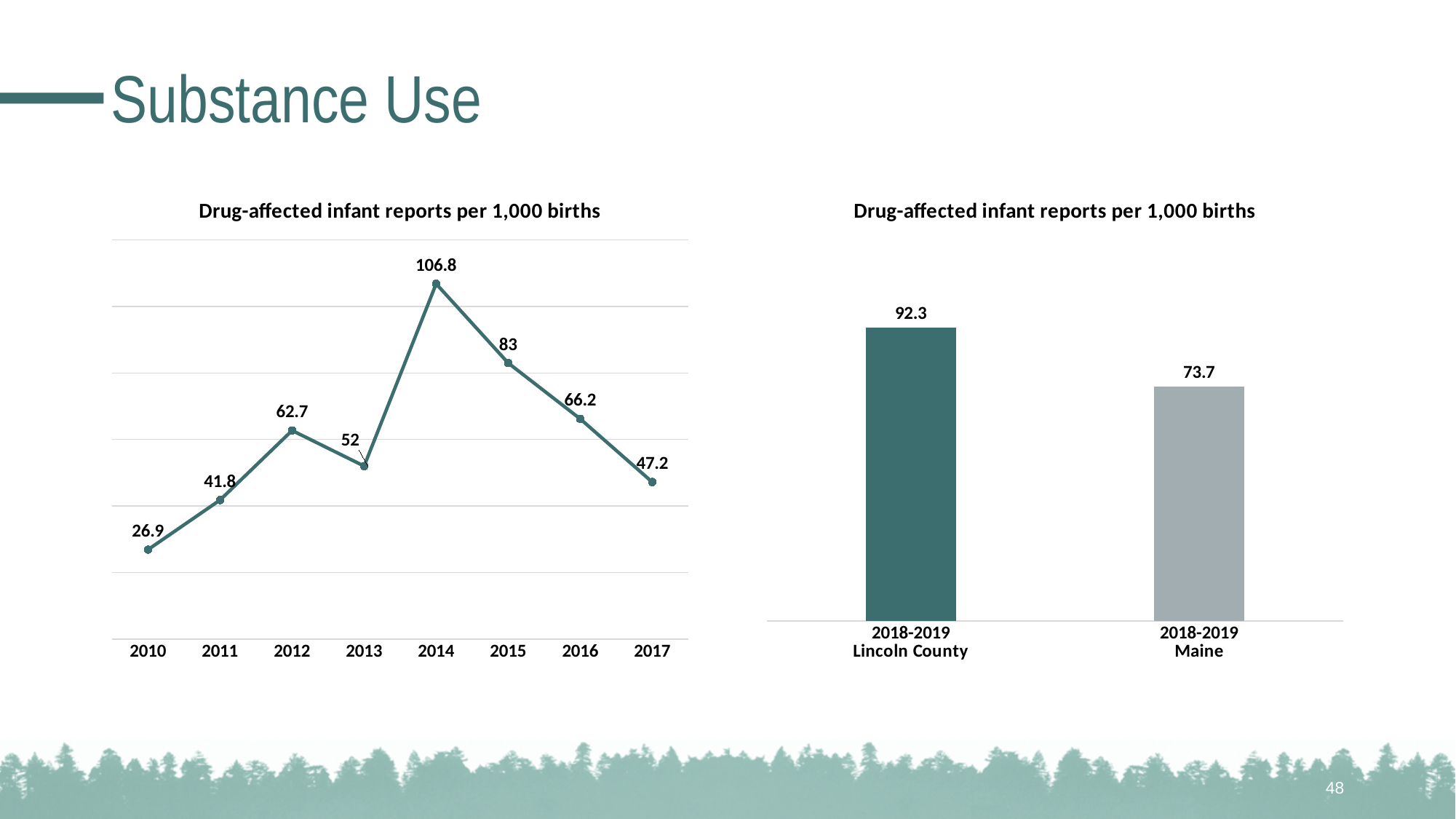
In the left line chart, what is the value for 2010? 26.9 In the left line chart, which is larger, the value for 2012 or the value for 2013? 2012 In the left line chart, how many years are plotted? 8 In the right bar chart, what is the value for 2018-2019 Maine? 73.7 In the left line chart, which year has the lowest value? 2010 In the left line chart, what is the difference between the values for 2014 and 2015? 23.8 In the left line chart, what is the value for 2014? 106.8 In the left line chart, which year has the highest value? 2014 In the left line chart, do the values rise or fall from 2014 to 2017? fall What kind of chart is the chart on the right? bar chart What kind of chart is the chart on the left? line chart In the right bar chart, what is the difference between the Lincoln County and Maine values? 18.6